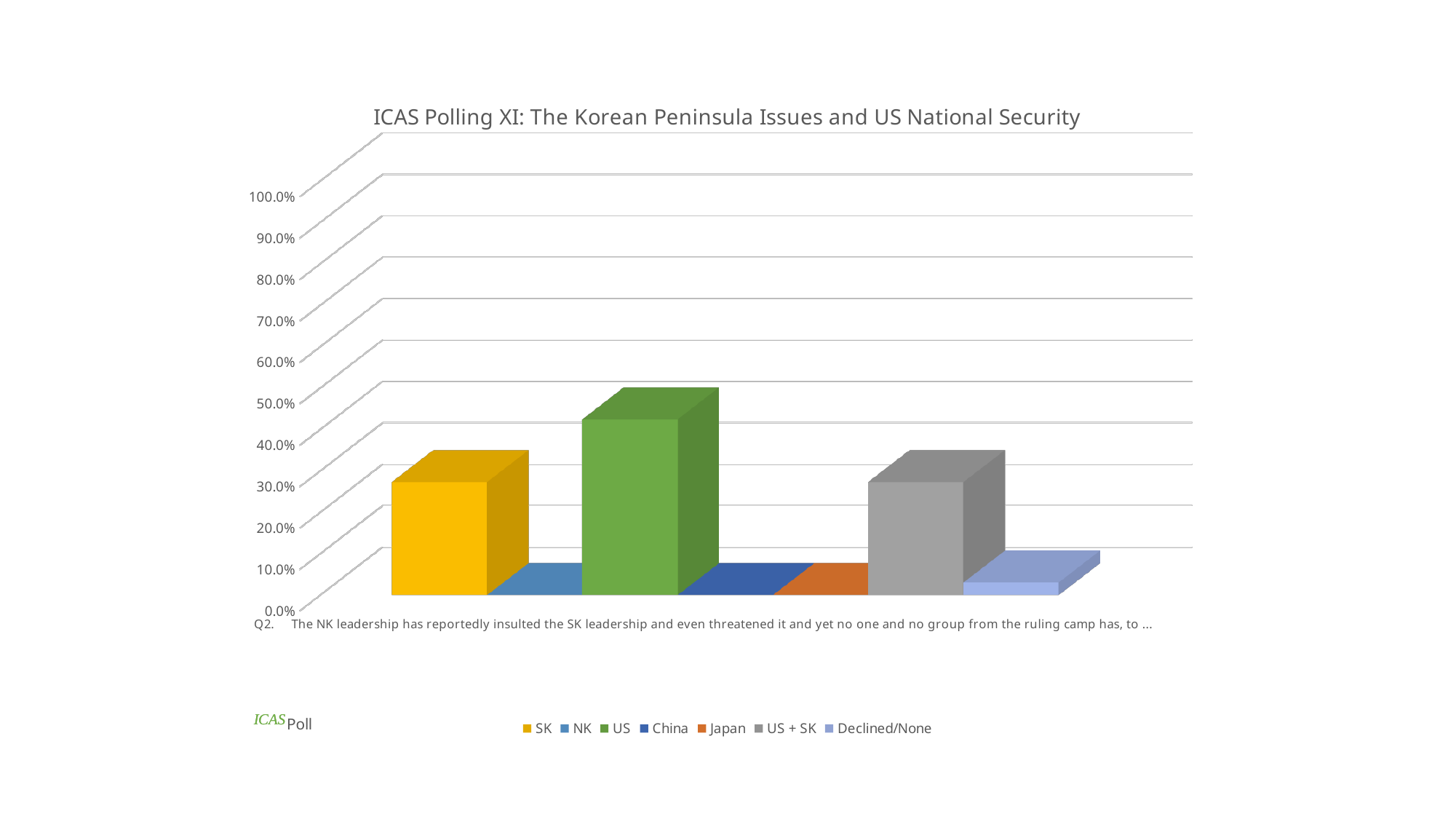
Is the value for SK greater or less than 20.0%? greater Which is larger, the value for US or the value for SK? US What kind of chart is shown on the slide? bar chart Which is larger, the value for SK or the value for NK? SK How many series does the legend list? 7 What colour is the bar for the US series? green Is the value for SK greater or less than 40.0%? less Is the value for US greater or less than 30.0%? greater Which series has the highest value in the chart? US What is the title of the chart? ICAS Polling XI: The Korean Peninsula Issues and US National Security